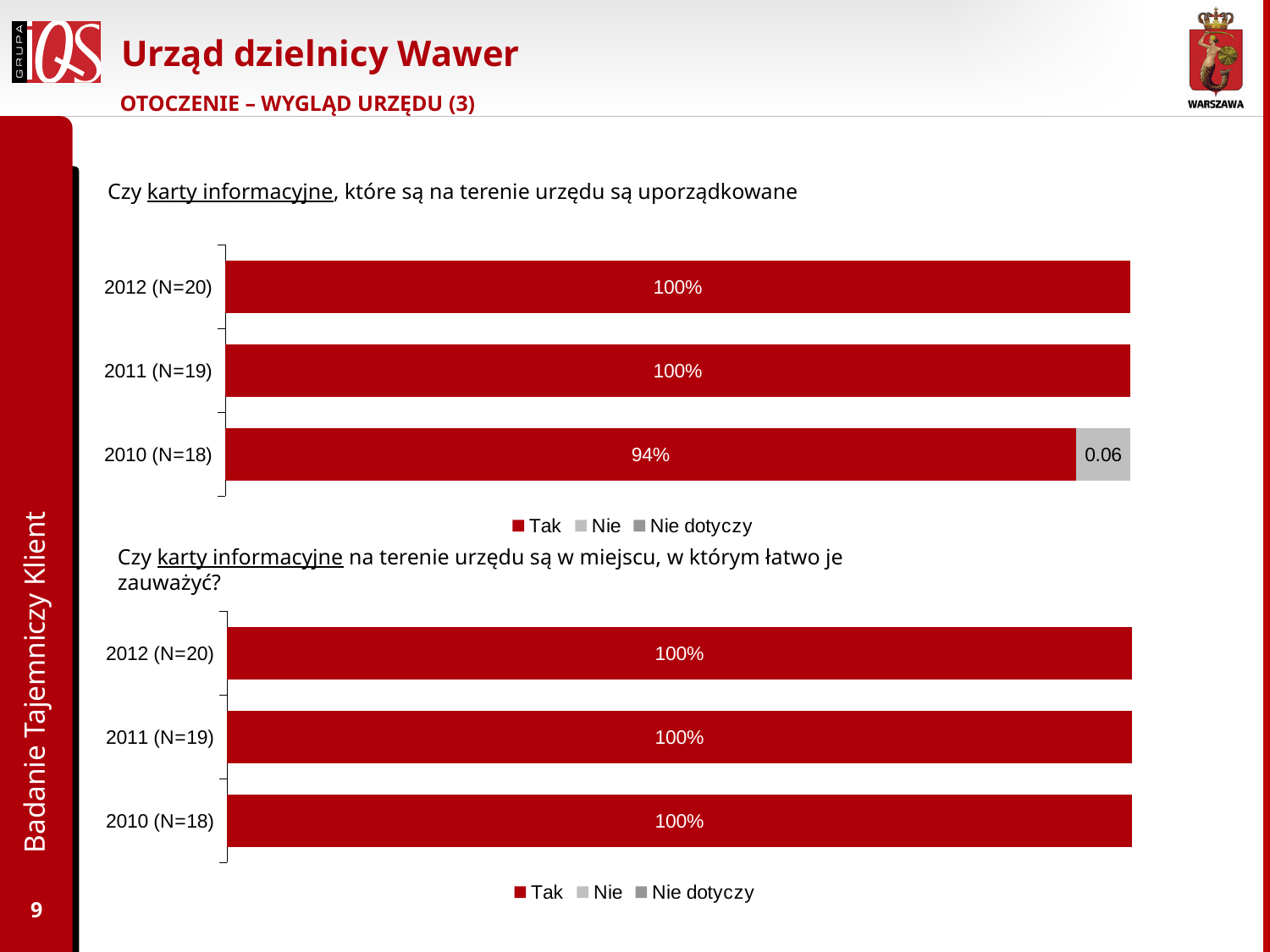
In the top chart, what is the difference between the Tak value for 2011 (N=19) and the Tak value for 2010 (N=18)? 6% What kind of chart is the bottom chart ("Czy karty informacyjne na terenie urzędu są w miejscu, w którym łatwo je zauważyć?")? bar chart What are the three legend entries of the bottom chart? Tak, Nie, Nie dotyczy In the top chart, is the Tak value for 2012 (N=20) larger or smaller than the Tak value for 2010 (N=18)? larger In the top chart ("Czy karty informacyjne, które są na terenie urzędu są uporządkowane"), what is the value of the Tak segment for 2010 (N=18)? 94% In the top chart, what value is printed on the grey segment of the 2010 (N=18) bar? 0.06 How many series does the legend of the top chart list? 3 In the bottom chart, what is the Tak value for 2010 (N=18)? 100% How many categories (years) are shown in the top chart? 3 In the top chart, what is the value of the Tak segment for 2012 (N=20)? 100% In the top chart, which year has the lowest Tak value? 2010 (N=18) In the bottom chart, what is the Tak value for 2011 (N=19)? 100%